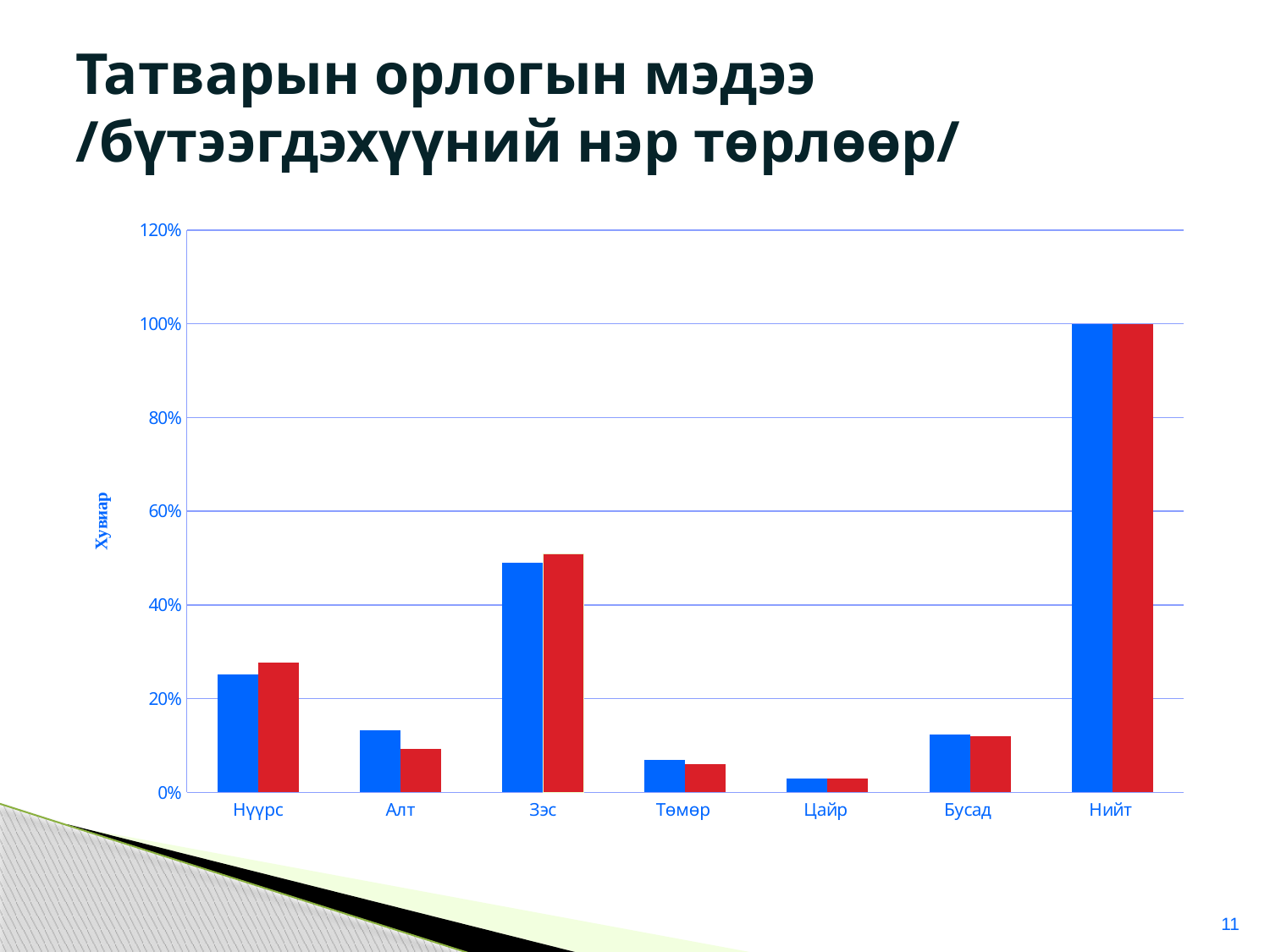
Is the value of the blue bar for Зэс greater or less than 40%? greater Is the value of the blue bar for Нүүрс greater or less than 40%? less How many categories are shown on the x axis of the chart? 7 What is the value of the blue bar for Нийт? 100% Is the value of the red bar for Бусад greater or less than 20%? less What is the value of the red bar for Нийт? 100% Which has the larger blue bar, Зэс or Нүүрс? Зэс What is the title of the vertical axis of the chart? Хувиар Which category has the highest bars in the chart? Нийт What kind of chart is shown on the slide? bar chart Which category has the lowest bars in the chart? Цайр For Алт, which bar is larger, the blue one or the red one? the blue one